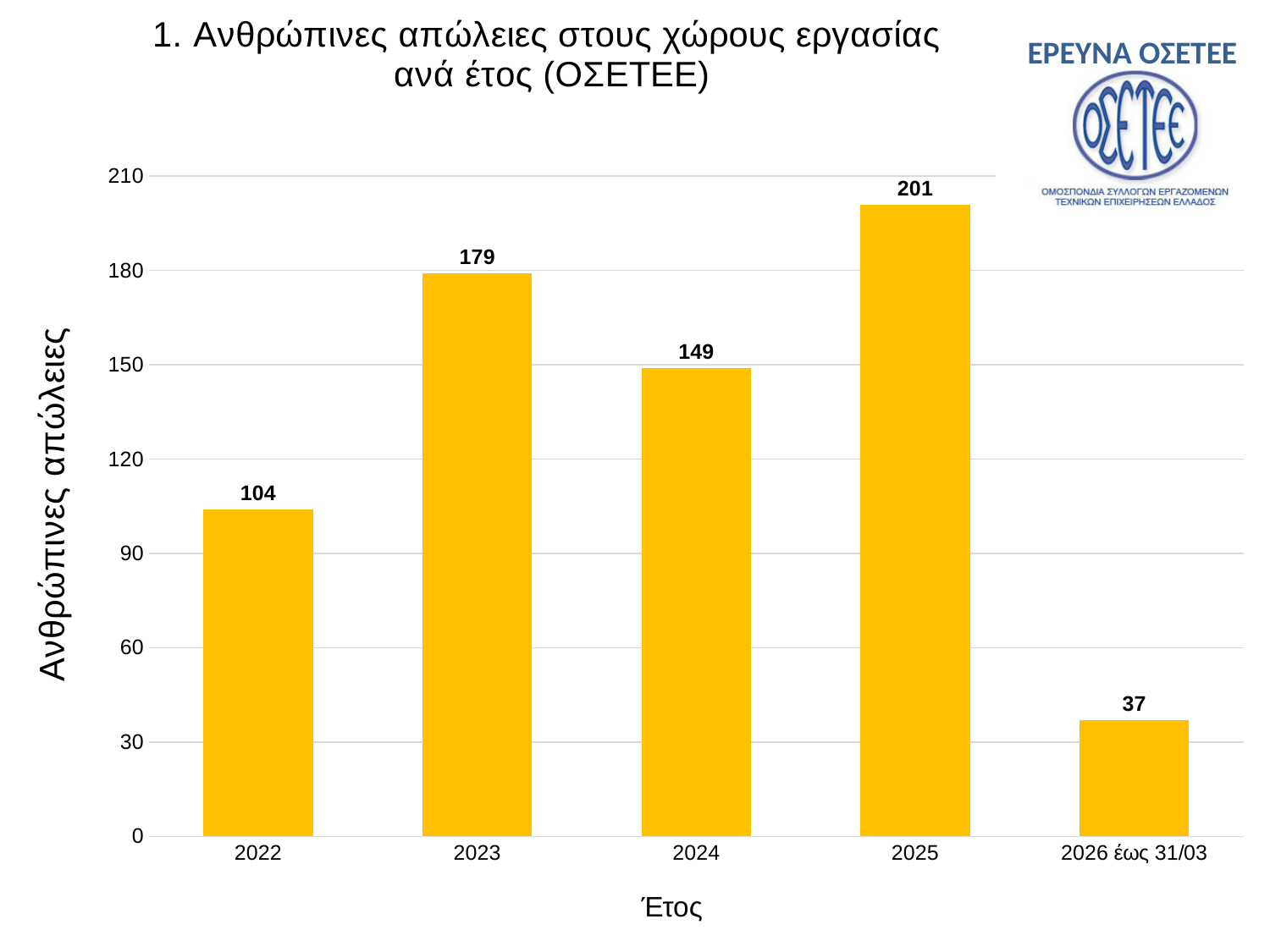
Which is larger, the value for 2023 or the value for 2024? 2023 Which year has the highest value? 2025 What is the value for 2023? 179 What kind of chart is shown on the slide? bar chart What is the value for 2025? 201 What is the value for 2026 έως 31/03? 37 Which category has the lowest value? 2026 έως 31/03 How many bars are shown in the chart? 5 What is the difference between the values for 2025 and 2022? 97 Is the value for 2022 greater or less than 90? greater What is the difference between the values for 2023 and 2024? 30 What is the label of the x axis? Έτος